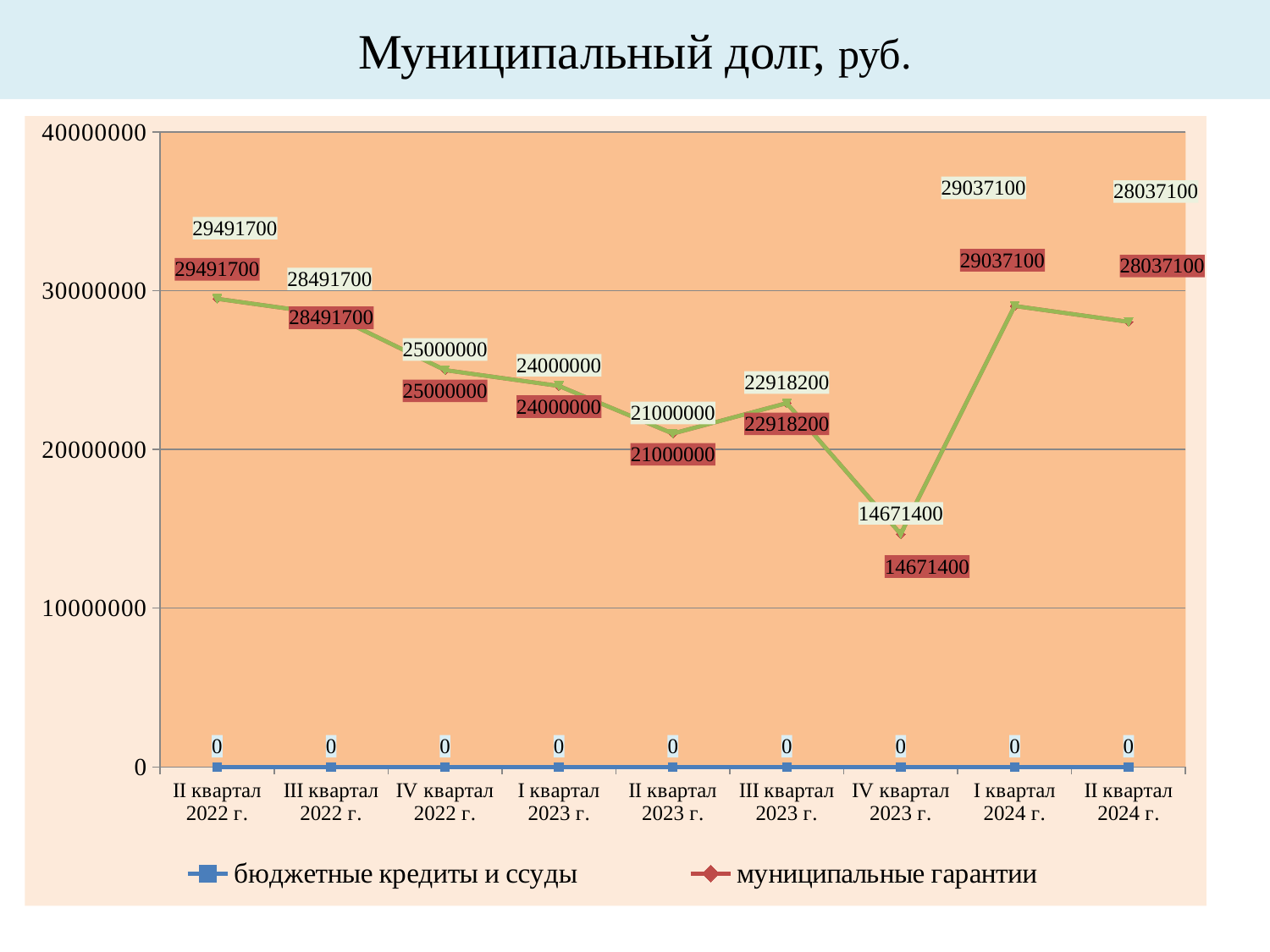
How many series does the legend list? 2 What is the value of муниципальные гарантии for I квартал 2024 г.? 29037100 In which quarter is the value of муниципальные гарантии the highest? II квартал 2022 г. What is the difference between the муниципальные гарантии values for I квартал 2024 г. and IV квартал 2023 г.? 14365700 What is the title of the chart? Муниципальный долг, руб. What kind of chart is shown on the slide? line chart In which quarter is the value of муниципальные гарантии the lowest? IV квартал 2023 г. Which is larger, the муниципальные гарантии value for III квартал 2023 г. or for II квартал 2023 г.? III квартал 2023 г. How many quarters are shown on the x axis? 9 What is the value of муниципальные гарантии for IV квартал 2023 г.? 14671400 What is the value of муниципальные гарантии for II квартал 2022 г.? 29491700 What is the value of бюджетные кредиты и ссуды for III квартал 2023 г.? 0